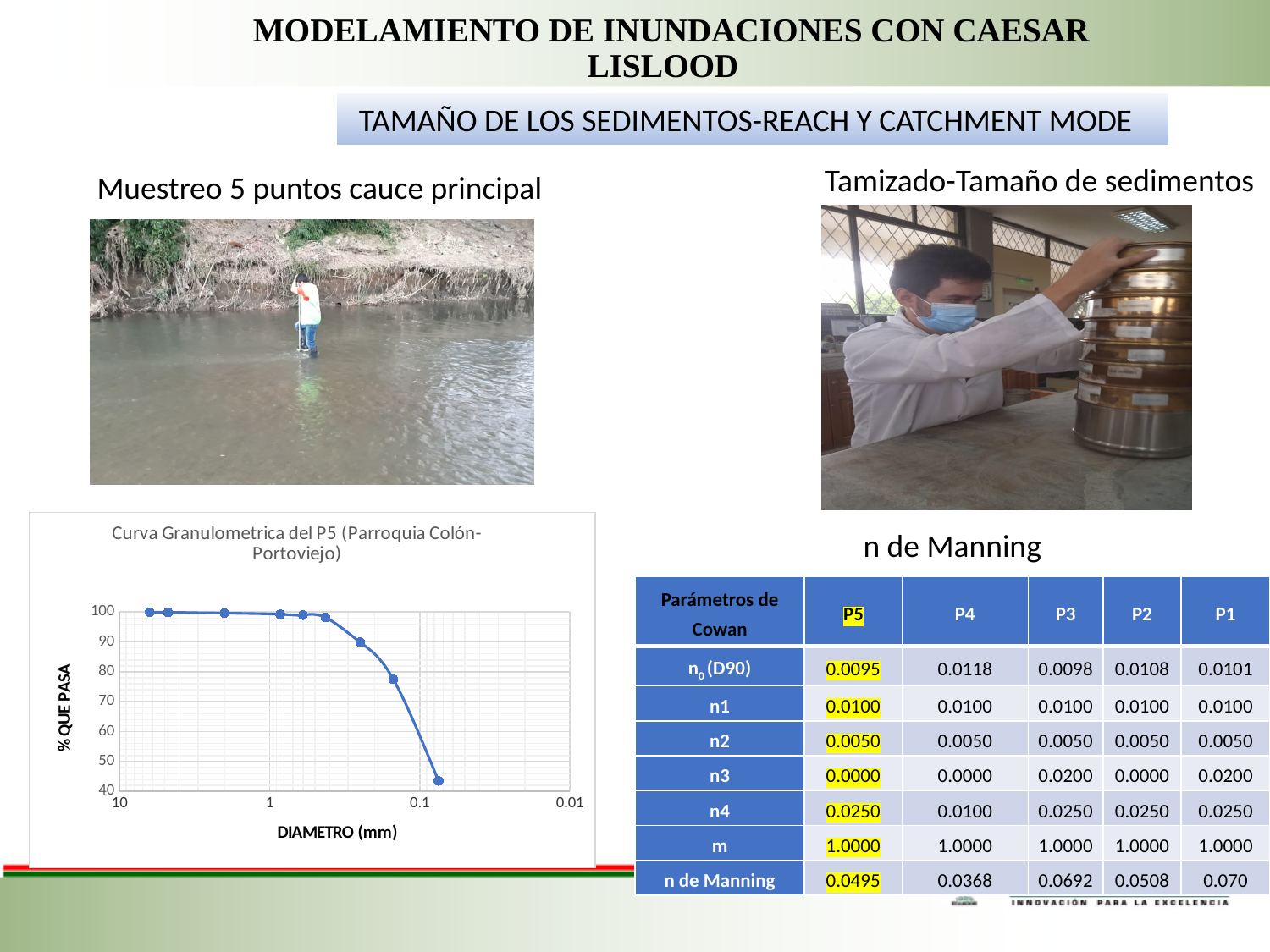
What is the label of the x axis of the chart? DIAMETRO (mm) Is the value for the smallest diameter plotted (rightmost point) greater or less than 50? less Is the value for the point just left of 0.1 mm greater or less than 70? greater What is the lowest value shown on the y axis of the chart? 40 What is the title of the chart on the slide? Curva Granulometrica del P5 (Parroquia Colón-Portoviejo) Which end of the x axis has the higher % QUE PASA values, the 10 mm end or the 0.01 mm end? 10 mm end Moving from left to right along the x axis, do the plotted values rise or fall? fall What kind of chart is shown on the slide? line chart How many data series are plotted in the chart? 1 Is the value for a diameter of 1 mm greater or less than 90? greater